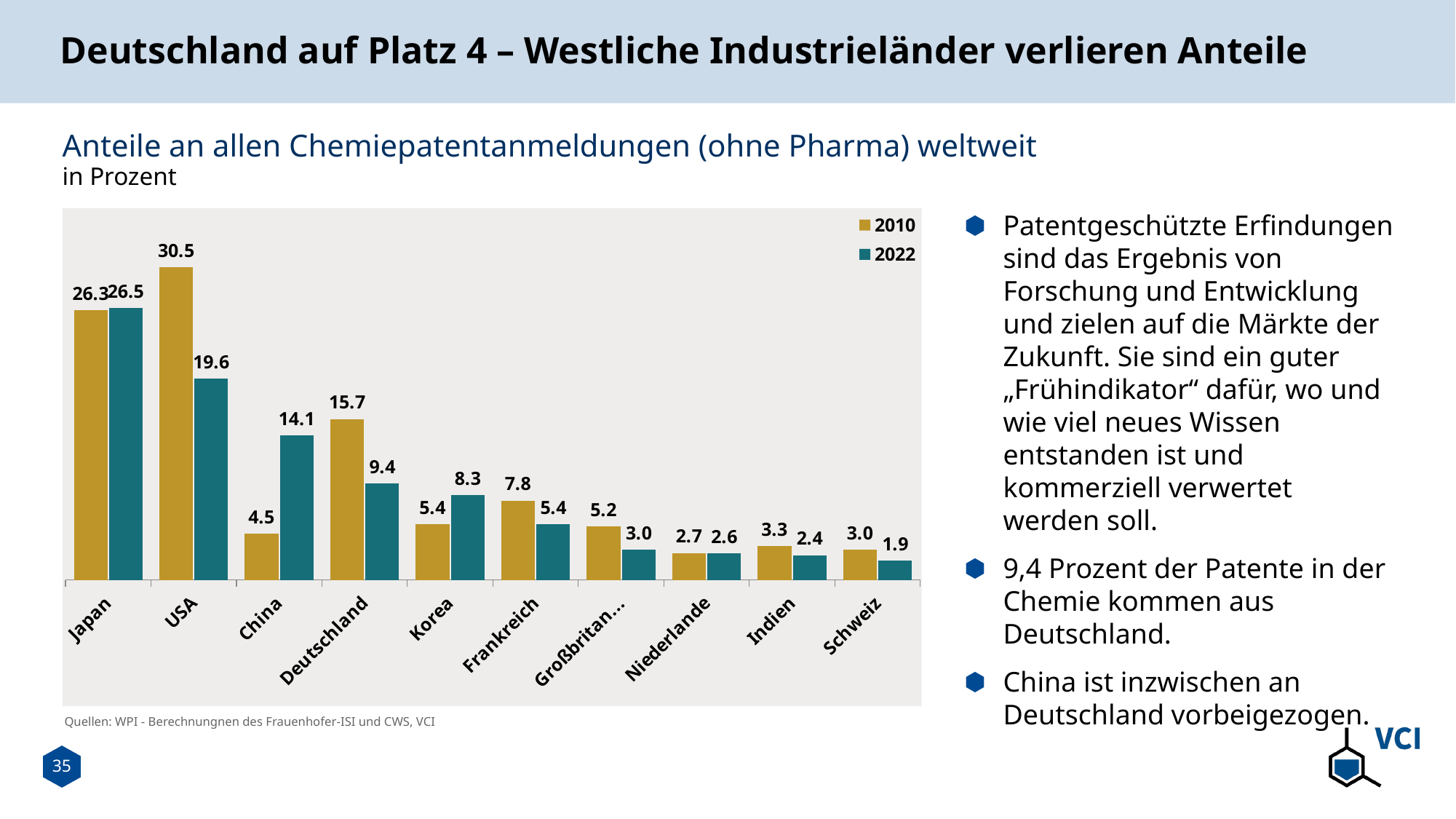
Which country has the lowest value in the 2022 series? Schweiz Which is larger in 2010: the value for Korea or the value for Frankreich? Frankreich What is the difference between Deutschland's 2010 and 2022 values? 6.3 How many series does the legend list? 2 How many countries are shown on the x axis? 10 Which is larger in 2022: the value for China or the value for Deutschland? China What was the value for China in 2010? 4.5 What was the value for USA in 2022? 19.6 What was the value for Deutschland in 2022? 9.4 What is the difference between the USA's 2010 and 2022 values? 10.9 Which country has the highest value in the 2010 series? USA What kind of chart is shown on the slide? Bar chart